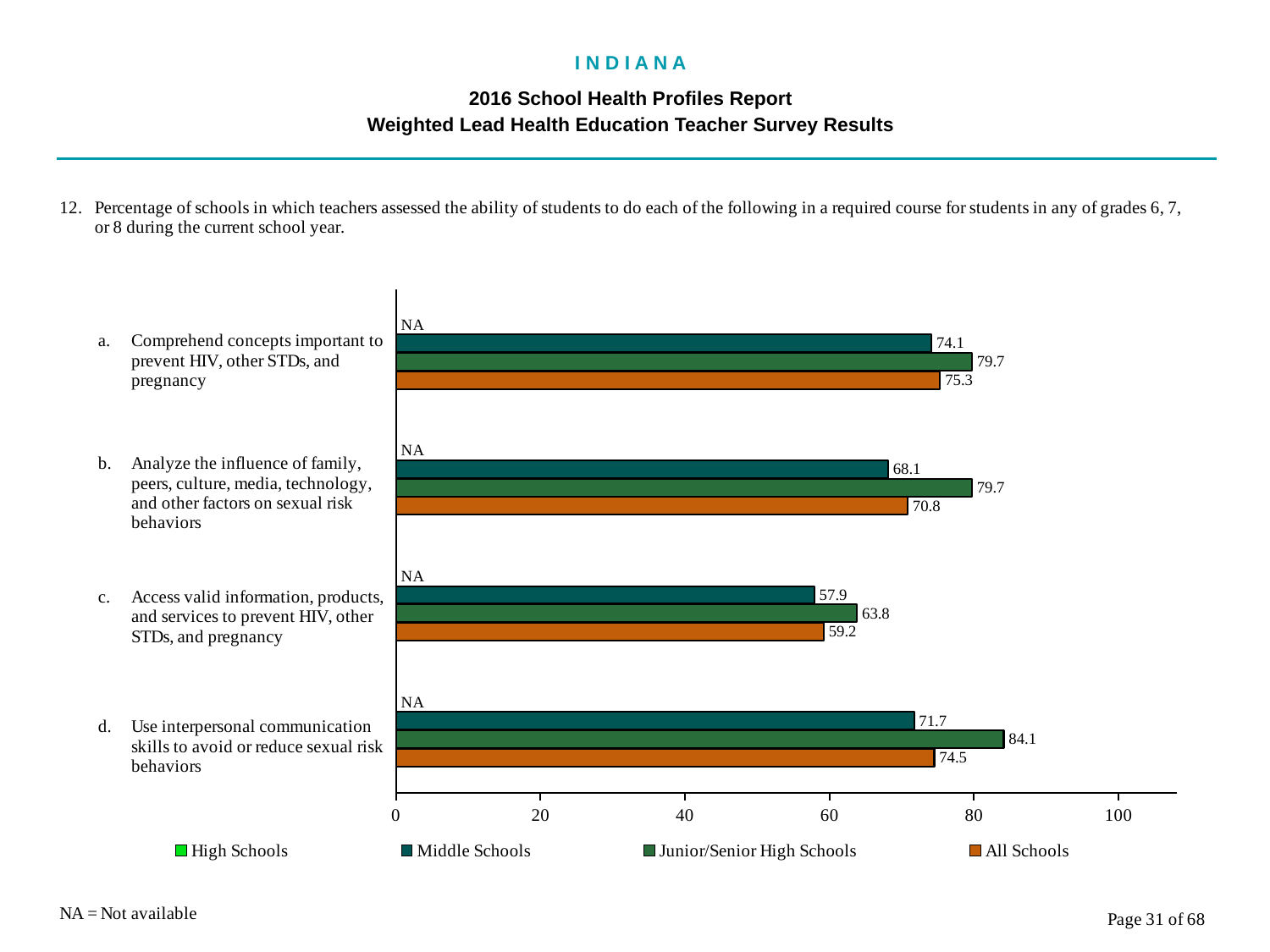
What kind of chart is shown on the slide? bar chart What is the All Schools value for item d, use interpersonal communication skills to avoid or reduce sexual risk behaviors? 74.5 How many items (categories) are shown on the chart? 4 Which item has the highest Junior/Senior High Schools value? d. Use interpersonal communication skills to avoid or reduce sexual risk behaviors Which item has the lowest Middle Schools value? c. Access valid information, products, and services to prevent HIV, other STDs, and pregnancy What is the Middle Schools value for item a, comprehend concepts important to prevent HIV, other STDs, and pregnancy? 74.1 How many series does the legend list? 4 What is the Junior/Senior High Schools value for item c, access valid information, products, and services to prevent HIV, other STDs, and pregnancy? 63.8 Which is larger for item b: the Middle Schools value or the All Schools value? All Schools What is the difference between the Junior/Senior High Schools and Middle Schools values for item d? 12.4 What value is shown for High Schools for each item? NA Is the All Schools value for item c greater or less than 60? less